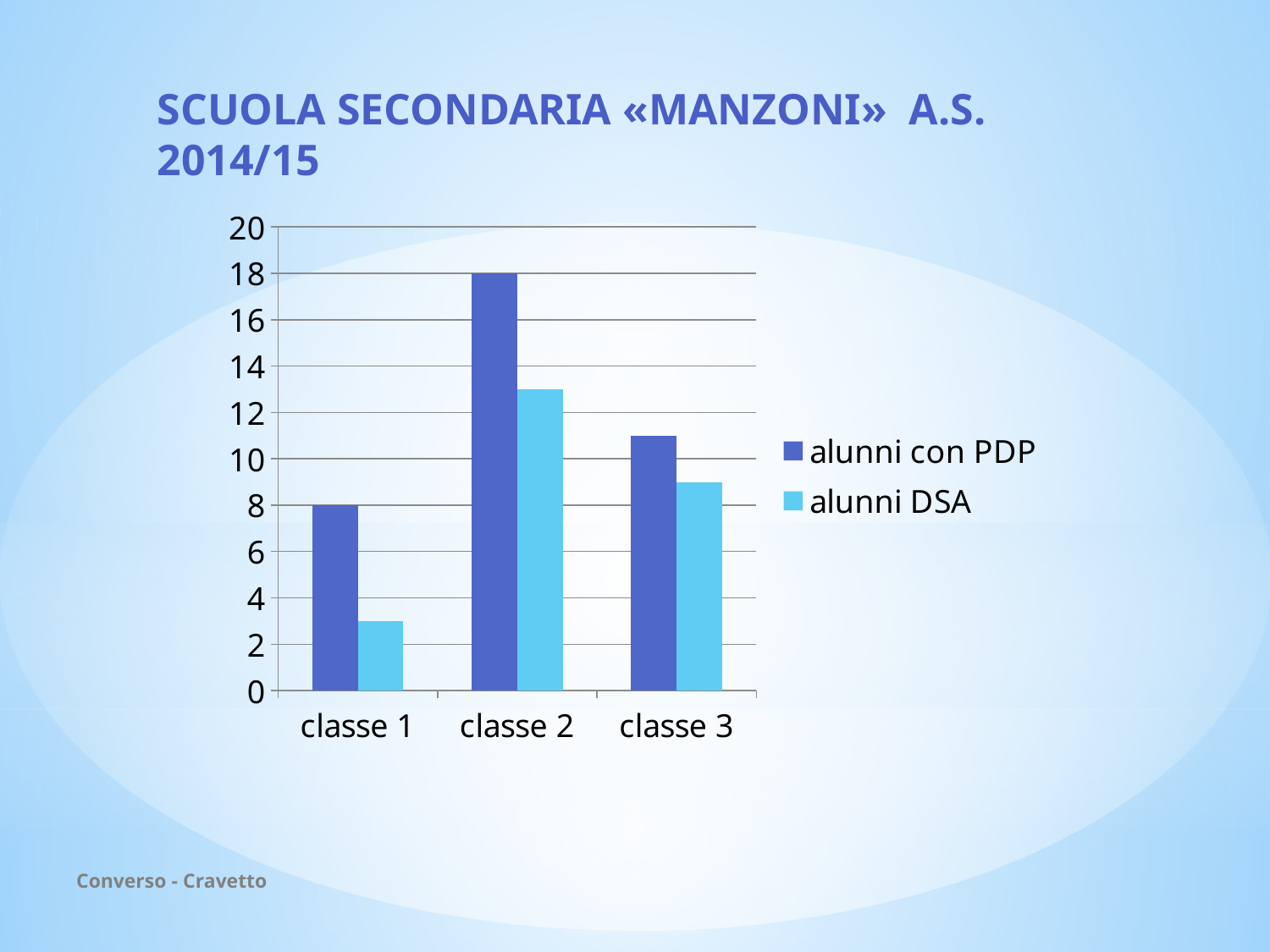
What is the difference between alunni con PDP in classe 2 and in classe 1? 10 What is the value for alunni con PDP in classe 1? 8 How many classes are shown on the x axis? 3 What is the value for alunni con PDP in classe 2? 18 What kind of chart is shown on the slide? bar chart Which class has the highest value for alunni con PDP? classe 2 Which is larger: alunni con PDP in classe 2 or alunni con PDP in classe 3? classe 2 Is the value for alunni DSA in classe 2 greater or less than 12? greater How many series does the legend list? 2 Is the value for alunni DSA in classe 3 greater or less than 10? less Which class has the lowest value for alunni DSA? classe 1 Is the value for alunni DSA in classe 1 greater or less than 4? less